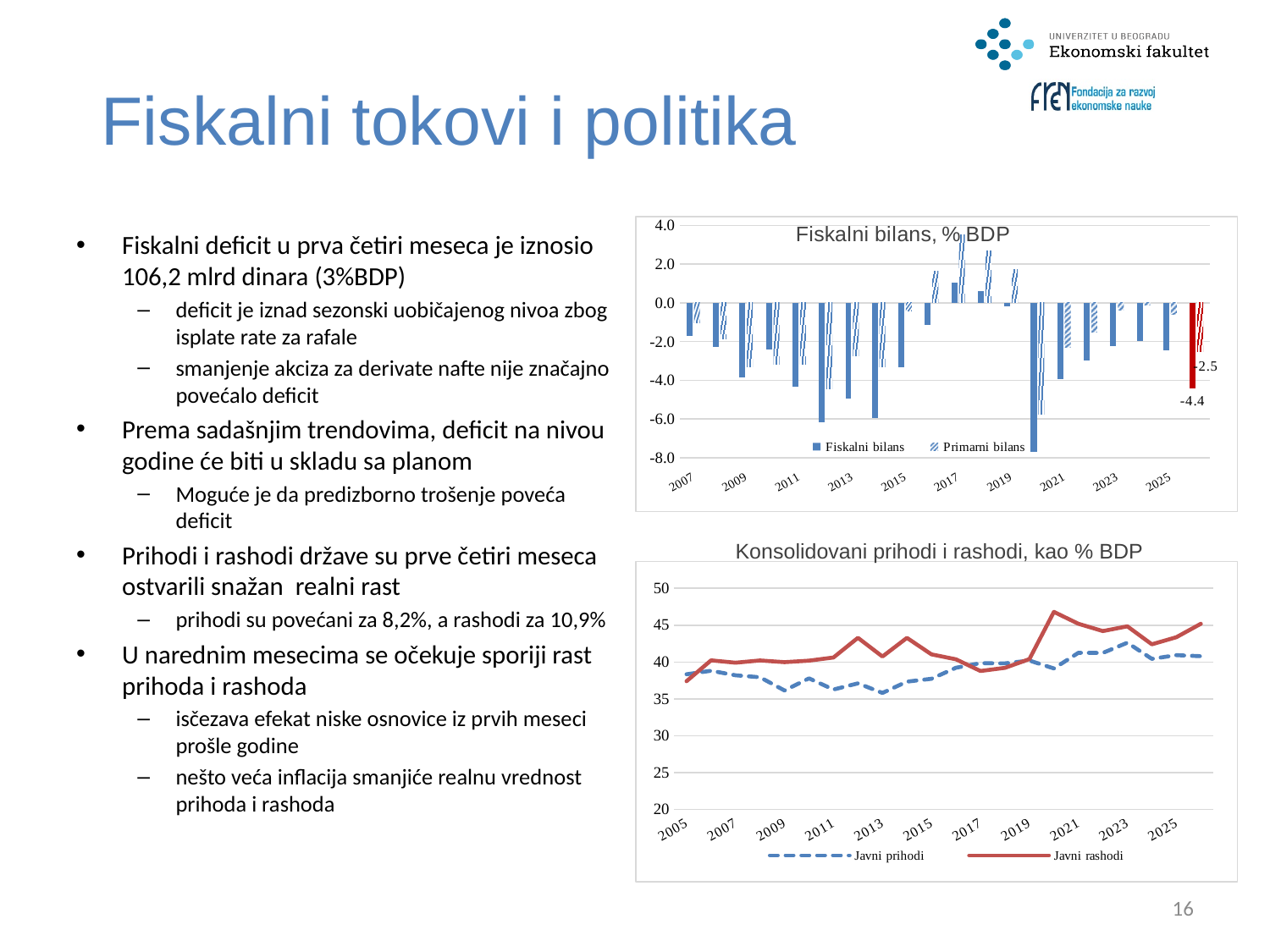
In the 'Fiskalni bilans, % BDP' chart, what value is labeled on the last hatched red bar? -2.5 In the 'Konsolidovani prihodi i rashodi, kao % BDP' chart, is the Javni prihodi value for 2009 greater or less than 40? less What type of chart is the 'Konsolidovani prihodi i rashodi, kao % BDP' chart? line chart In the 'Fiskalni bilans, % BDP' chart, which year has the lowest Fiskalni bilans value? 2020 In the 'Konsolidovani prihodi i rashodi, kao % BDP' chart, how many series does the legend list? 2 How many series does the legend of the 'Fiskalni bilans, % BDP' chart list? 2 In the 'Konsolidovani prihodi i rashodi, kao % BDP' chart, which year has the highest Javni rashodi value? 2020 In the 'Konsolidovani prihodi i rashodi, kao % BDP' chart, which series has the larger value in 2020, Javni prihodi or Javni rashodi? Javni rashodi In the 'Fiskalni bilans, % BDP' chart, is the Fiskalni bilans value for 2020 greater or less than -6.0? less What type of chart is the 'Fiskalni bilans, % BDP' chart? bar chart In the 'Fiskalni bilans, % BDP' chart, what value is labeled on the last solid red bar? -4.4 In the 'Konsolidovani prihodi i rashodi, kao % BDP' chart, is the Javni rashodi value for 2020 greater or less than 45? greater